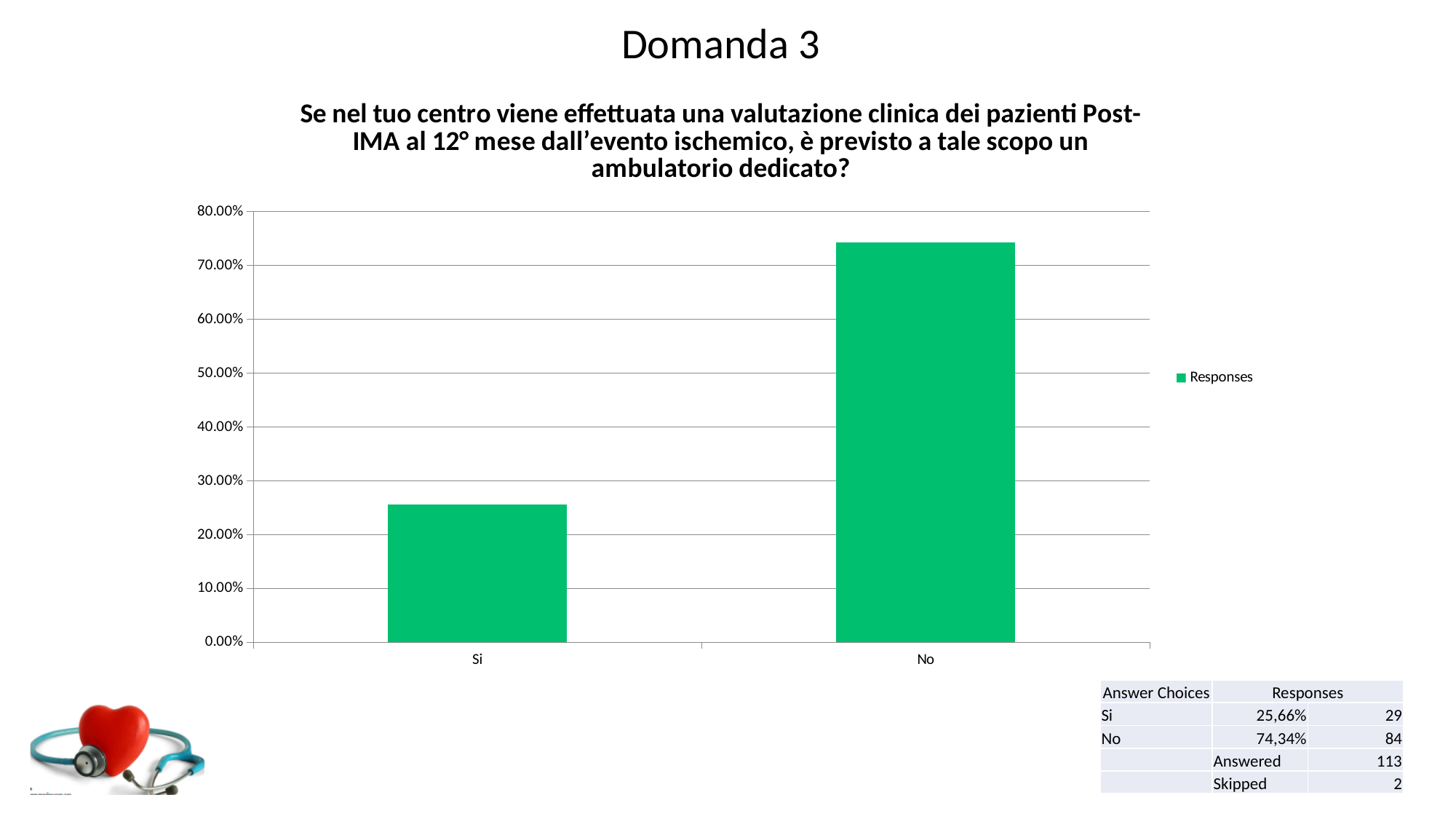
Is the value for No greater or less than 70.00%? greater How many categories are shown on the x axis of the chart? 2 What type of chart is shown on the slide? bar chart Is the value for Si greater or less than 20.00%? greater Which is larger, the value for Si or the value for No? No What is the name of the series shown in the chart legend? Responses According to the table on the slide, what percentage of responses were Si? 25,66% How many series does the chart legend list? 1 According to the table on the slide, what percentage of responses were No? 74,34% Which category has the lowest value in the chart? Si Which category has the highest value in the chart? No Is the value for Si greater or less than 30.00%? less